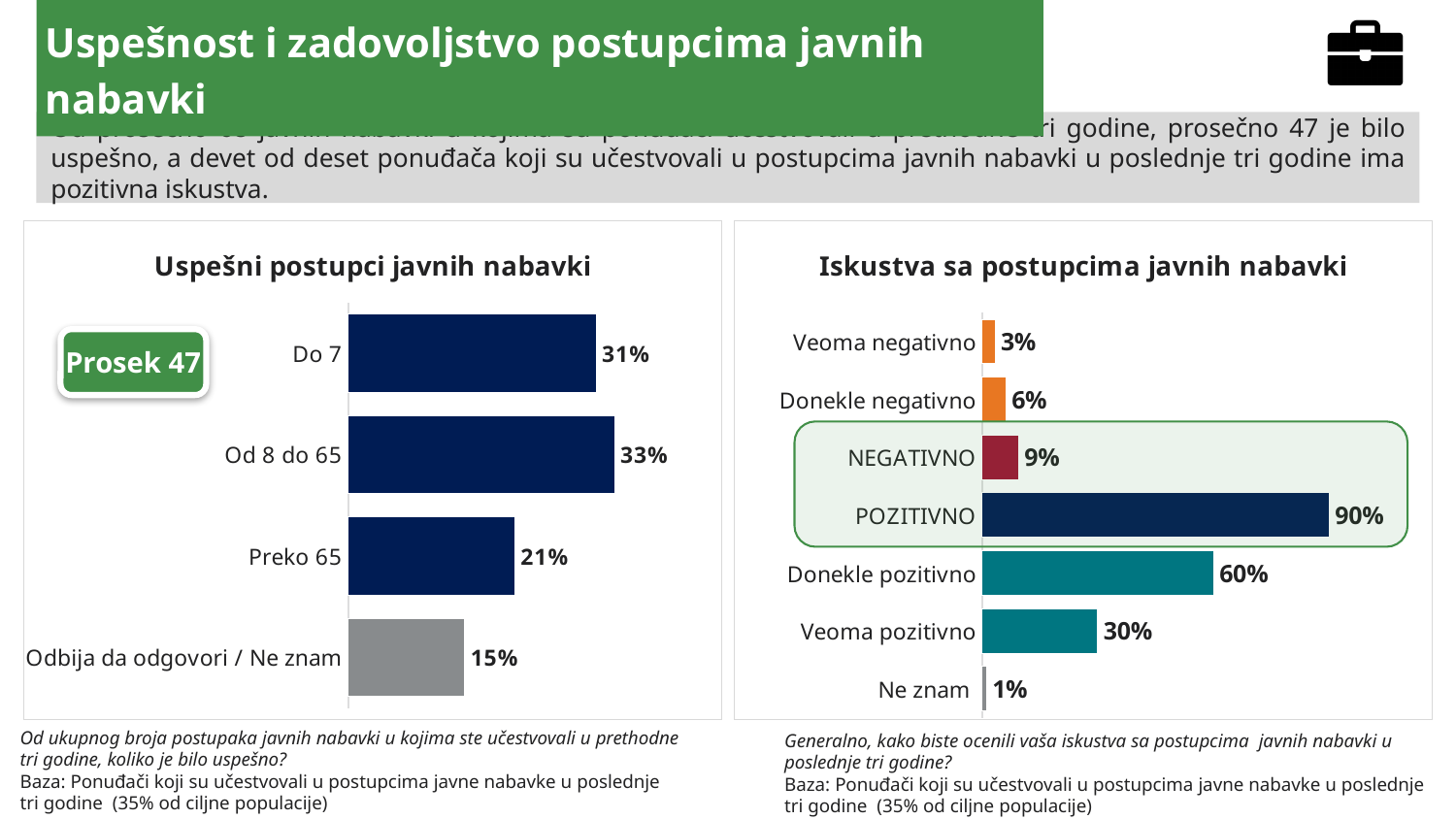
In the chart 'Uspešni postupci javnih nabavki', what is the value for 'Od 8 do 65'? 33% In the chart 'Iskustva sa postupcima javnih nabavki', how many categories are shown? 7 In the chart 'Uspešni postupci javnih nabavki', which category has the lowest value? Odbija da odgovori / Ne znam In the chart 'Iskustva sa postupcima javnih nabavki', what is the difference between 'POZITIVNO' and 'NEGATIVNO'? 81% In the chart 'Iskustva sa postupcima javnih nabavki', which category has the highest value? POZITIVNO In the chart 'Iskustva sa postupcima javnih nabavki', what is the value for 'Veoma negativno'? 3% In the chart 'Uspešni postupci javnih nabavki', what type of chart is used? Bar chart In the chart 'Uspešni postupci javnih nabavki', what is the difference between 'Do 7' and 'Preko 65'? 10% In the chart 'Uspešni postupci javnih nabavki', how many categories are shown? 4 In the chart 'Iskustva sa postupcima javnih nabavki', which category has the lowest value? Ne znam In the chart 'Iskustva sa postupcima javnih nabavki', which is larger: 'Donekle negativno' or 'Veoma pozitivno'? Veoma pozitivno In the chart 'Iskustva sa postupcima javnih nabavki', what is the value for 'Donekle pozitivno'? 60%